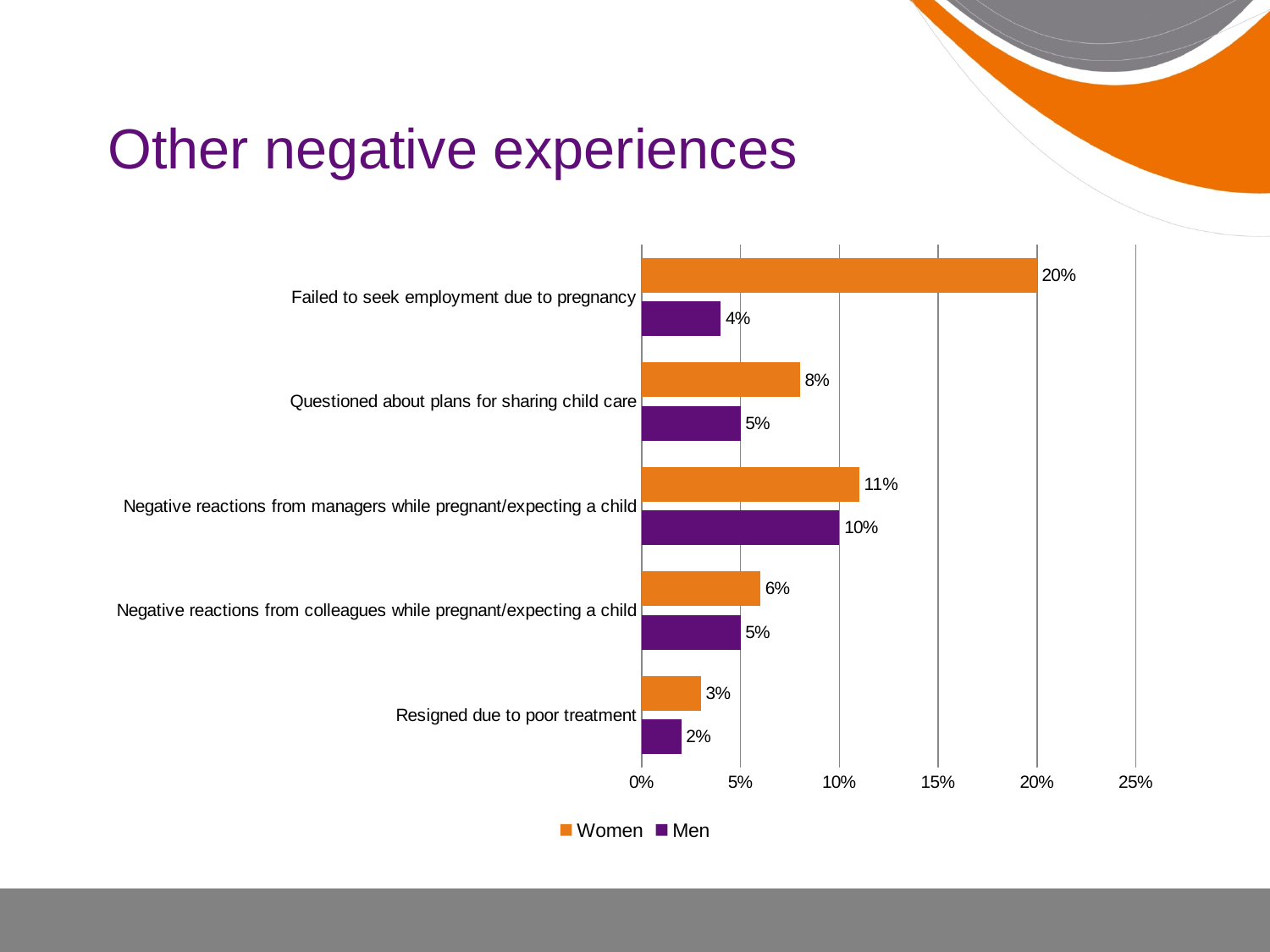
What is the title of the slide? Other negative experiences How many categories are shown on the chart? 5 How many series does the legend list? 2 What is the value for women for 'Resigned due to poor treatment'? 3% What is the value for men for 'Negative reactions from managers while pregnant/expecting a child'? 10% What is the difference between the women's and men's values for 'Failed to seek employment due to pregnancy'? 16% Which category has the lowest value for men? Resigned due to poor treatment What percentage of women failed to seek employment due to pregnancy? 20% Which is larger for 'Questioned about plans for sharing child care': the value for women or for men? Women What kind of chart is shown on the slide? Bar chart Which colour represents the Men series? Purple Which category has the highest value for women? Failed to seek employment due to pregnancy